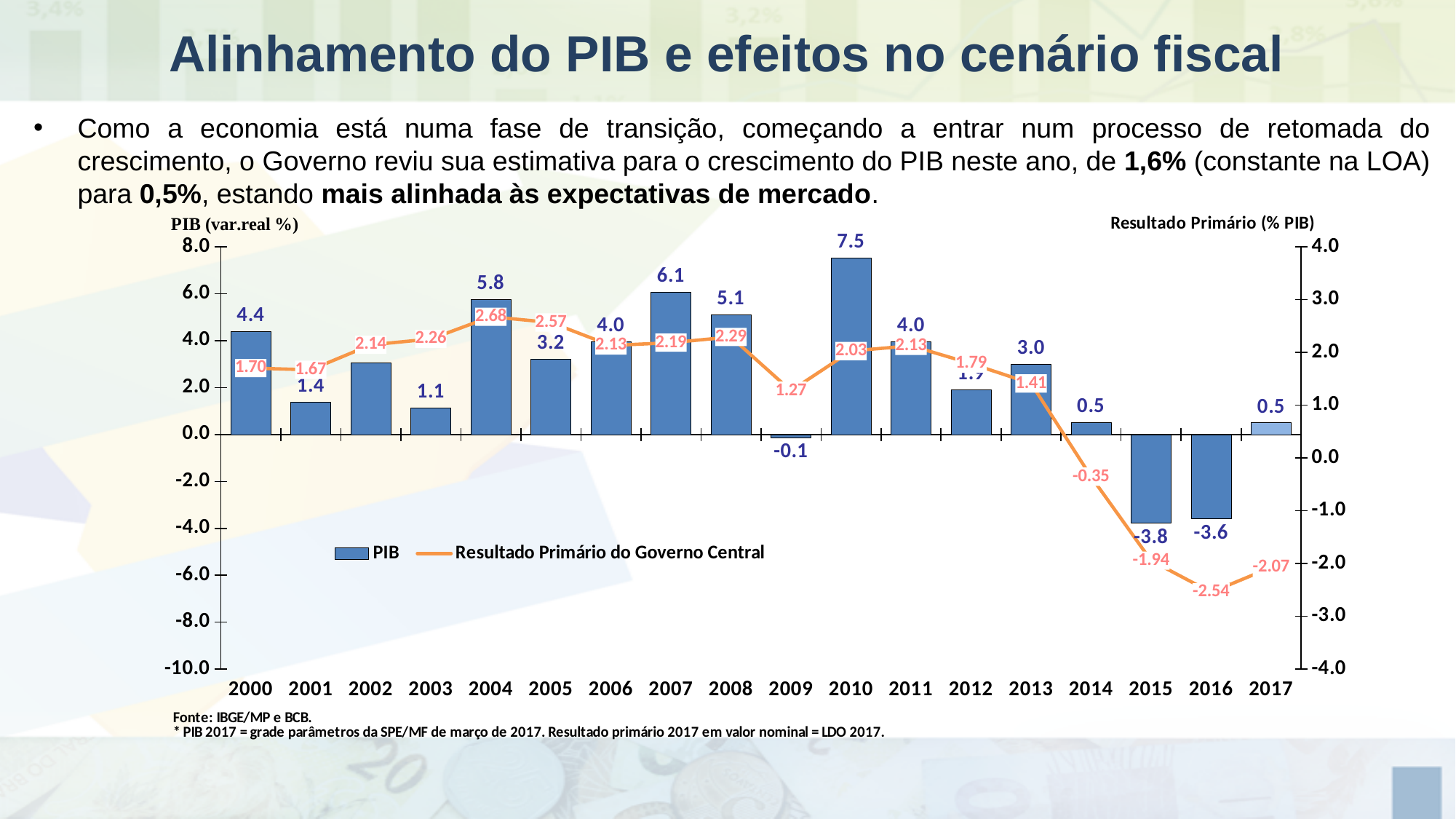
Which year has the lowest PIB value? 2015 Which year has the lowest Resultado Primário do Governo Central value? 2016 How many series does the chart legend list? 2 Is the PIB value for 2002 greater or less than 2.0? greater Does the Resultado Primário do Governo Central line rise or fall from 2013 to 2016? Fall What kind of chart is shown on the slide? Combination bar and line chart What is the difference between the PIB values for 2007 and 2008? 1.0 How many years are shown on the x axis of the chart? 18 What is the Resultado Primário do Governo Central value for 2004? 2.68 Which year has the highest PIB value? 2010 Which is larger, the PIB value for 2004 or for 2008? 2004 What is the PIB value for 2010? 7.5